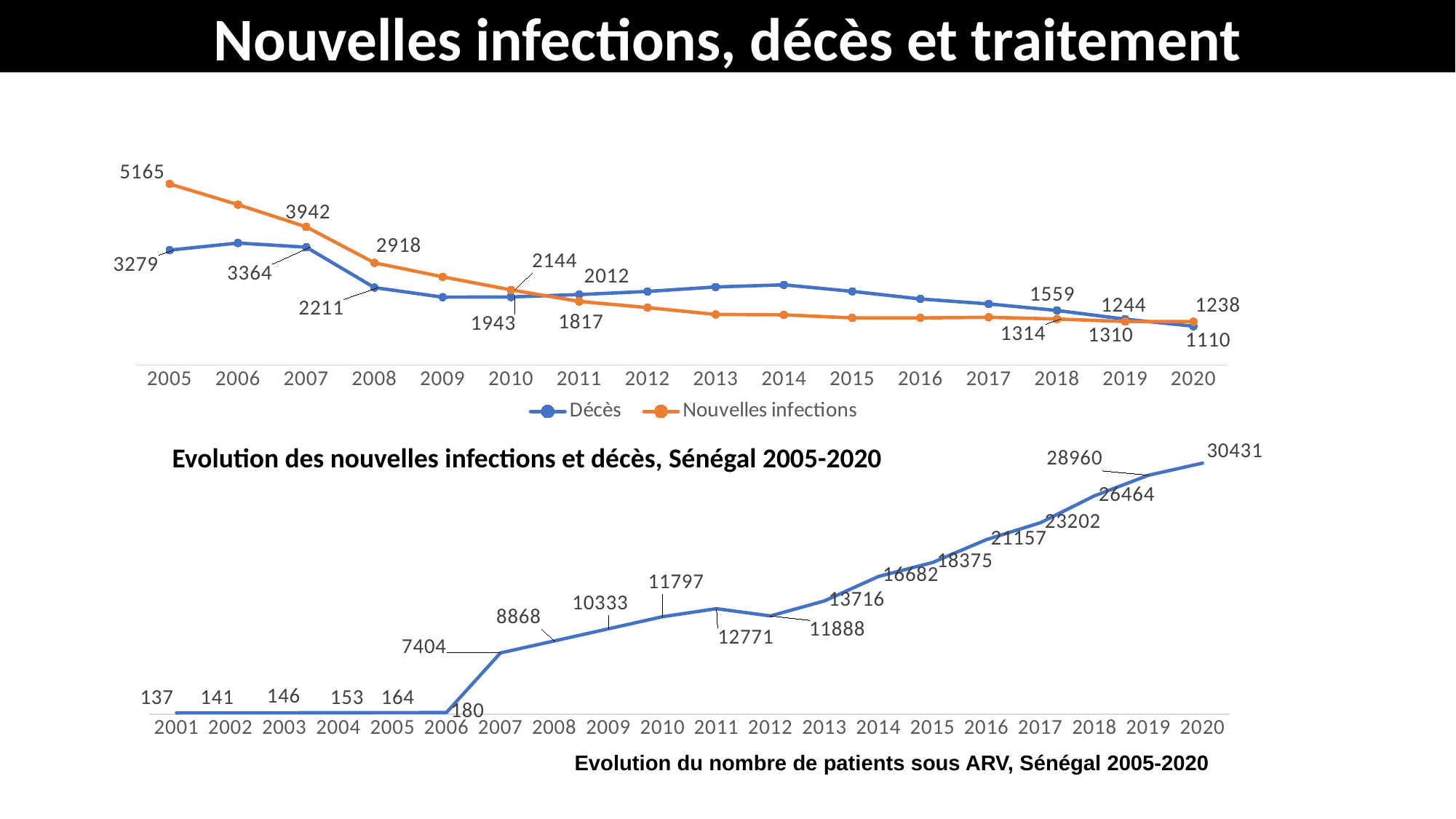
In the top chart (Evolution des nouvelles infections et décès), what kind of chart is it? Line chart In the bottom chart (Evolution du nombre de patients sous ARV), what is the difference between the 2020 and 2019 values? 1471 In the top chart (Evolution des nouvelles infections et décès), what is the value for Décès in 2020? 1110 In the top chart (Evolution des nouvelles infections et décès), what is the value for Nouvelles infections in 2005? 5165 In the bottom chart (Evolution du nombre de patients sous ARV), what is the value for 2001? 137 In the bottom chart (Evolution du nombre de patients sous ARV), which year has the larger value, 2011 or 2012? 2011 In the bottom chart (Evolution du nombre de patients sous ARV), what is the value for 2020? 30431 In the top chart (Evolution des nouvelles infections et décès), do the Nouvelles infections values rise or fall from 2005 to 2020? Fall In the bottom chart (Evolution du nombre de patients sous ARV), how many years are plotted on the x axis? 20 In the top chart (Evolution des nouvelles infections et décès), what is the difference between Nouvelles infections and Décès in 2005? 1886 In the top chart (Evolution des nouvelles infections et décès), how many series does the legend list? 2 In the top chart (Evolution des nouvelles infections et décès), what is the value for Nouvelles infections in 2008? 2918